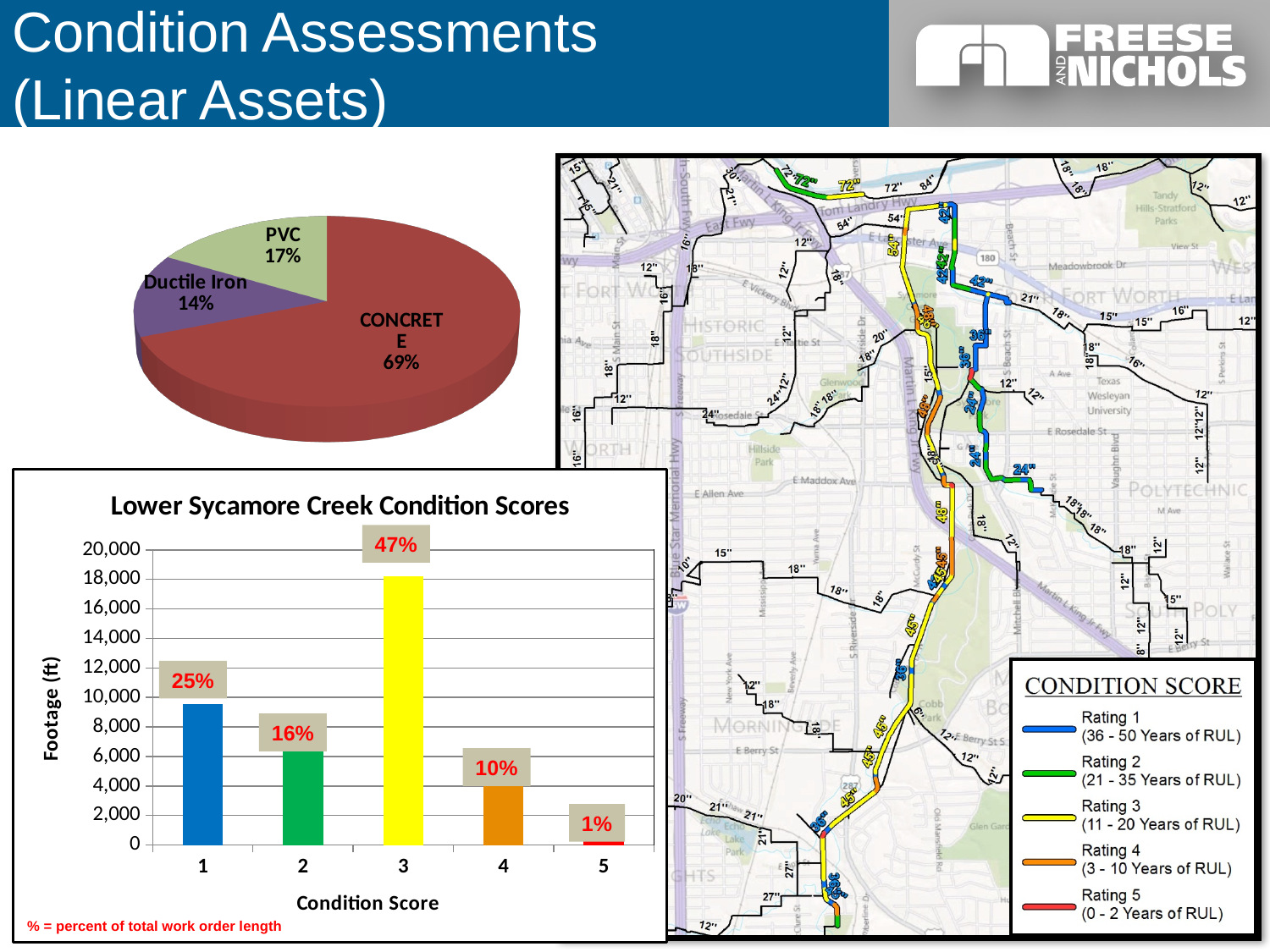
In the pie chart, which material has the largest share? CONCRETE In the Lower Sycamore Creek Condition Scores chart, which condition score has the highest footage? 3 In the pie chart, what percentage is labelled for Ductile Iron? 14% In the Lower Sycamore Creek Condition Scores chart, what percentage label is shown above the bar for condition score 3? 47% In the pie chart, what percentage is labelled for CONCRETE? 69% In the pie chart, how many slices are shown? 3 In the pie chart, what percentage is labelled for PVC? 17% In the Lower Sycamore Creek Condition Scores chart, what percentage label is shown for condition score 5? 1% What kind of chart is the Lower Sycamore Creek Condition Scores chart? Bar chart In the pie chart, which material has the smallest share? Ductile Iron In the Lower Sycamore Creek Condition Scores chart, is the footage for condition score 1 greater or less than 8,000? greater In the Lower Sycamore Creek Condition Scores chart, what is the difference between the percentage labels for condition score 1 and condition score 2? 9%